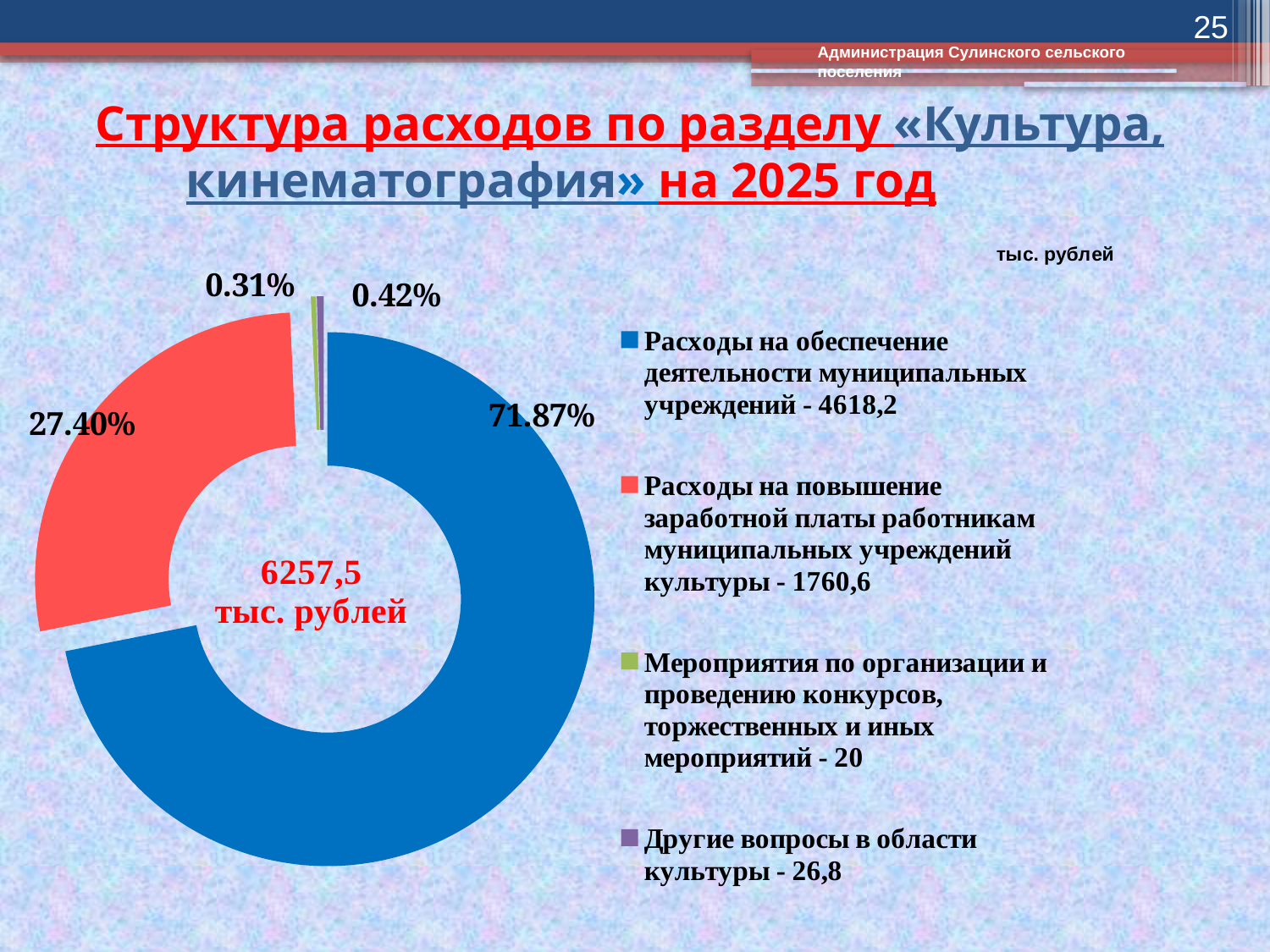
What total amount is shown in the centre of the doughnut chart? 6257,5 тыс. рублей What share of the chart does the slice for "Мероприятия по организации и проведению конкурсов, торжественных и иных мероприятий" represent? 0.31% What kind of chart is shown on the slide? Doughnut (pie) chart What share of the chart does the slice for "Расходы на обеспечение деятельности муниципальных учреждений" represent? 71.87% What value (in тыс. рублей) is given in the legend for "Другие вопросы в области культуры"? 26,8 What value (in тыс. рублей) is given in the legend for "Расходы на обеспечение деятельности муниципальных учреждений"? 4618,2 What share of the chart does the slice for "Расходы на повышение заработной платы работникам муниципальных учреждений культуры" represent? 27.40% Which category has the smallest slice of the chart? Мероприятия по организации и проведению конкурсов, торжественных и иных мероприятий Which category has the largest slice of the chart? Расходы на обеспечение деятельности муниципальных учреждений What value (in тыс. рублей) is given in the legend for "Расходы на повышение заработной платы работникам муниципальных учреждений культуры"? 1760,6 How many categories does the legend of the chart list? 4